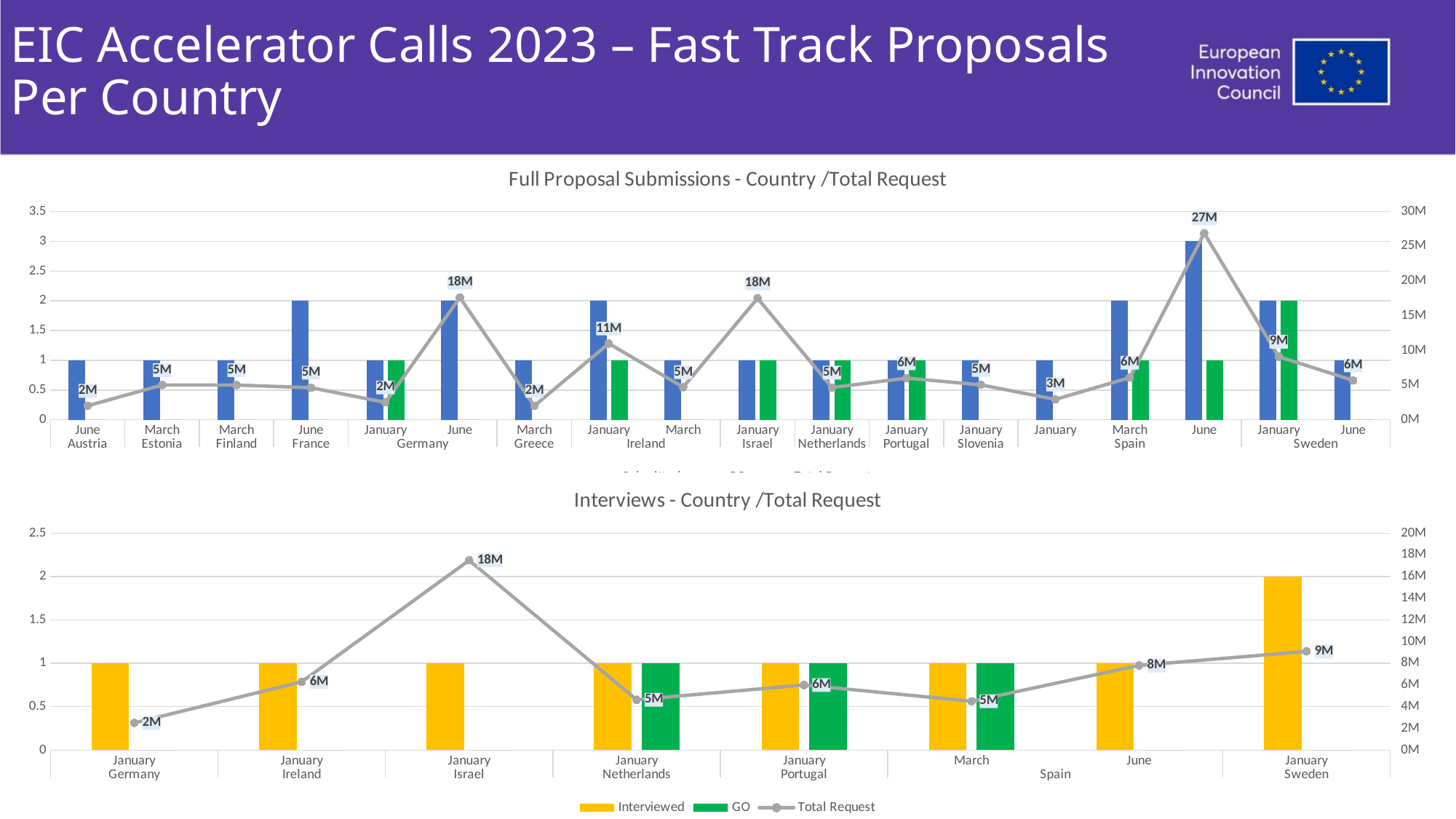
In the bottom chart (Interviews - Country /Total Request), which has the larger Total Request: June Spain or January Sweden? January Sweden In the bottom chart (Interviews - Country /Total Request), how many categories are shown on the x axis? 8 In the top chart (Full Proposal Submissions - Country /Total Request), which category has the highest Total Request? June Spain In the bottom chart (Interviews - Country /Total Request), which category has the lowest Total Request? January Germany In the top chart (Full Proposal Submissions - Country /Total Request), what is the difference between the Total Request for June Germany and January Germany? 16M In the bottom chart (Interviews - Country /Total Request), how many series does the legend list? 3 In the bottom chart (Interviews - Country /Total Request), what is the Interviewed value for January Sweden? 2 In the top chart (Full Proposal Submissions - Country /Total Request), what is the Total Request value for June Spain? 27M In the bottom chart (Interviews - Country /Total Request), what colour represents the Interviewed series in the legend? Yellow In the top chart (Full Proposal Submissions - Country /Total Request), what is the Total Request value for January Ireland? 11M In the top chart (Full Proposal Submissions - Country /Total Request), how many categories are shown on the x axis? 18 In the bottom chart (Interviews - Country /Total Request), what is the Total Request value for January Israel? 18M